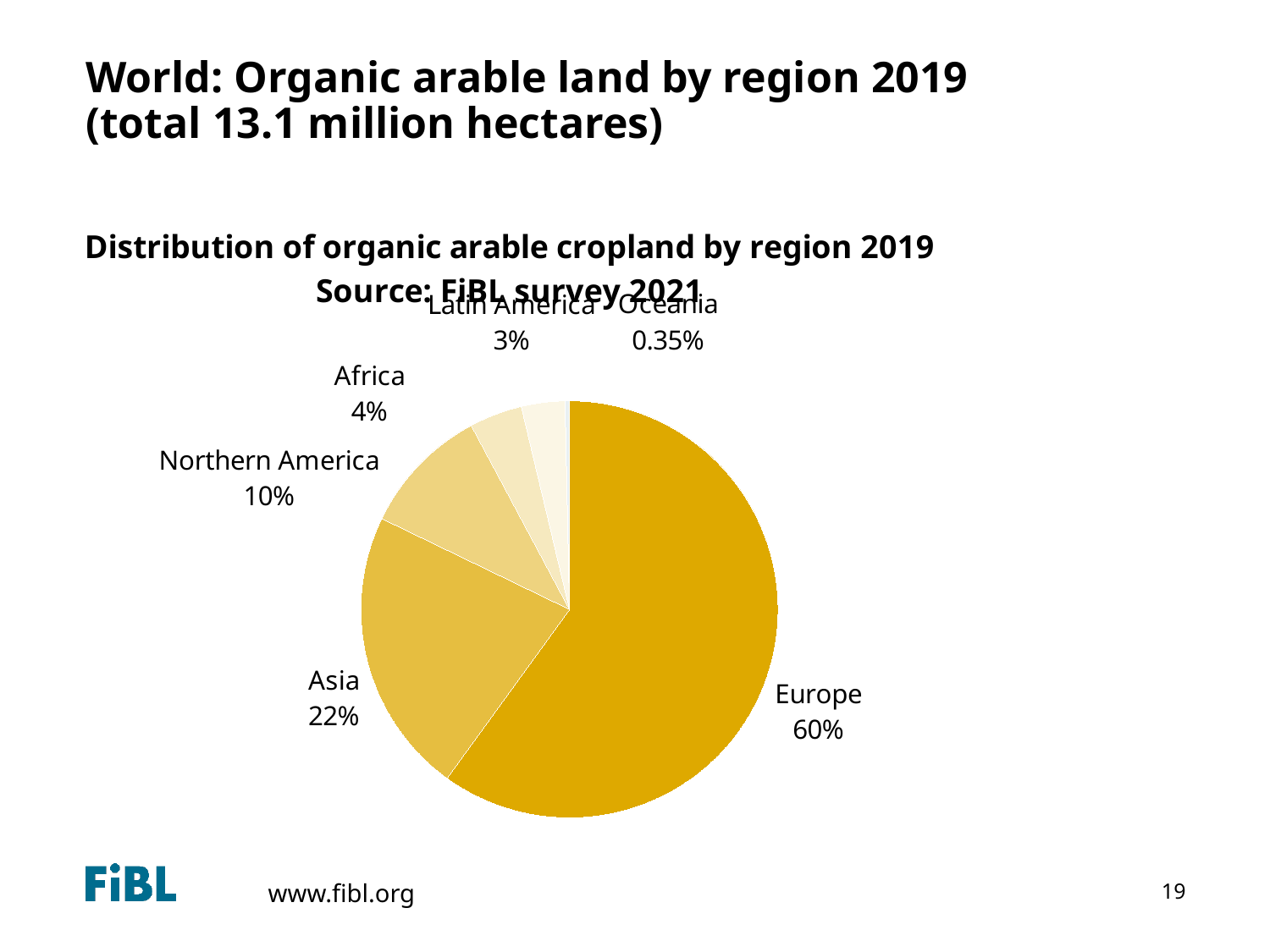
What is the title of the chart? Distribution of organic arable cropland by region 2019 Source: FiBL survey 2021 What kind of chart is shown on the slide? Pie chart Which is larger, the share for Africa or the share for Latin America? Africa What percentage is shown for Northern America? 10% What is the value shown for Asia? 22% What is the value shown for Oceania? 0.35% What is the difference in percentage points between Europe and Asia? 38 Which region has the largest slice of the pie? Europe Which region has the smallest slice of the pie? Oceania What share of organic arable cropland does Europe hold? 60% What is the difference in percentage points between Northern America and Africa? 6 How many regions are shown in the pie chart? 6